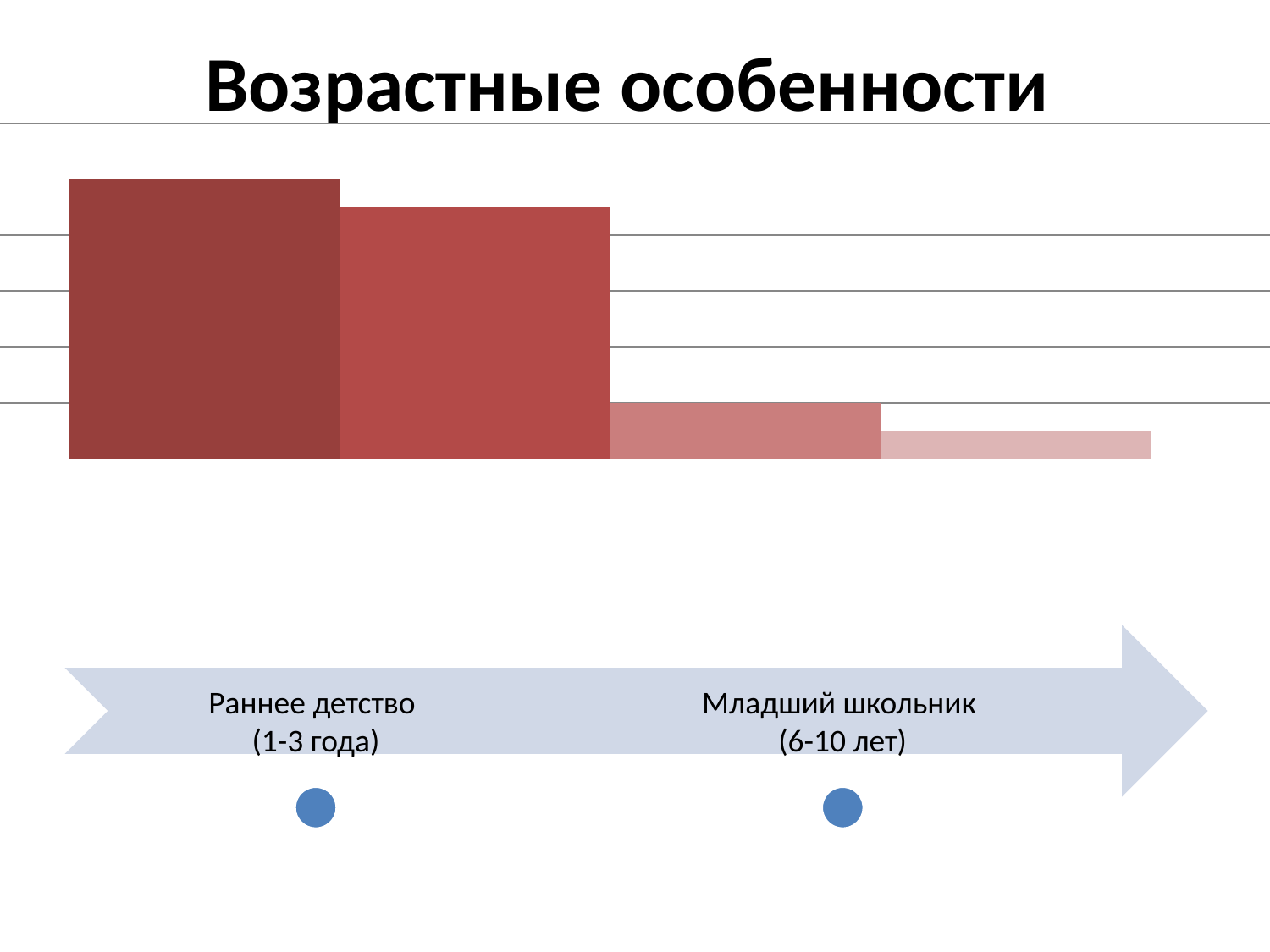
Which is taller, the third bar from the left or the fourth bar? the third bar Which bar is the shortest in the chart: the first, second, third or fourth from the left? the fourth Which bar is the tallest in the chart: the first, second, third or fourth from the left? the first What kind of chart is shown on the slide? bar chart Do the bar heights rise or fall from left to right across the chart? fall Which is taller, the second bar from the left or the third bar? the second bar How many bars does the chart contain? 4 Does the chart display a legend? no What colour family are the bars in the chart? shades of red Which is taller, the first bar from the left or the second bar? the first bar